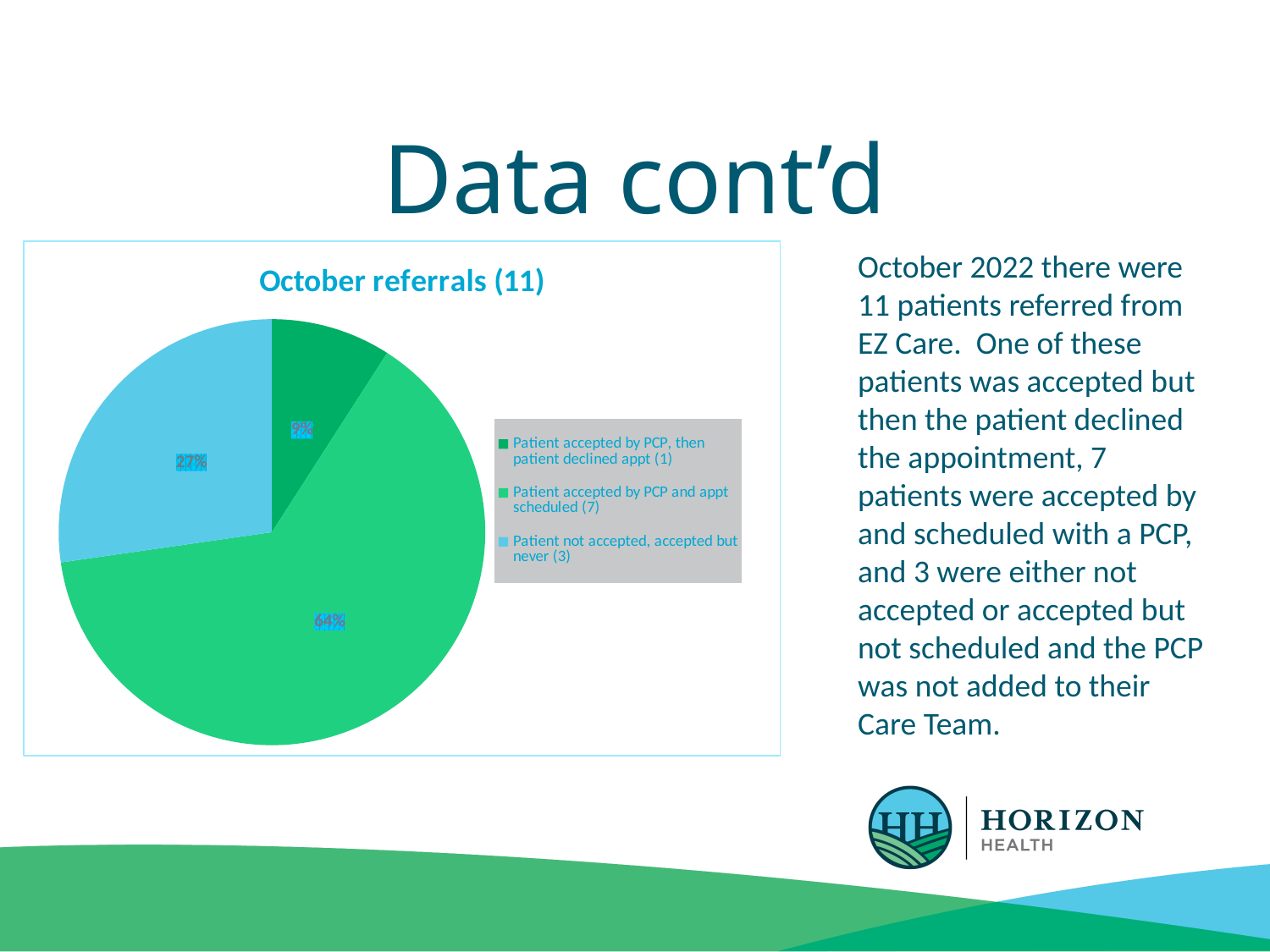
How many entries does the legend list? 3 Which is larger: the share for 'Patient not accepted, accepted but never' or the share for 'Patient accepted by PCP, then patient declined appt'? Patient not accepted, accepted but never Which category has the smallest share of the pie? Patient accepted by PCP, then patient declined appt What kind of chart is shown on the slide? pie chart How many slices does the pie chart have? 3 What is the difference in percentage points between the 'Patient accepted by PCP and appt scheduled' slice and the 'Patient not accepted, accepted but never' slice? 37 Which category has the largest share of the pie? Patient accepted by PCP and appt scheduled What is the title of the chart? October referrals (11) What percentage of the pie is 'Patient not accepted, accepted but never'? 27% How many patients does the legend give for 'Patient accepted by PCP and appt scheduled'? 7 What percentage of the pie is 'Patient accepted by PCP and appt scheduled'? 64% What percentage of the pie is 'Patient accepted by PCP, then patient declined appt'? 9%